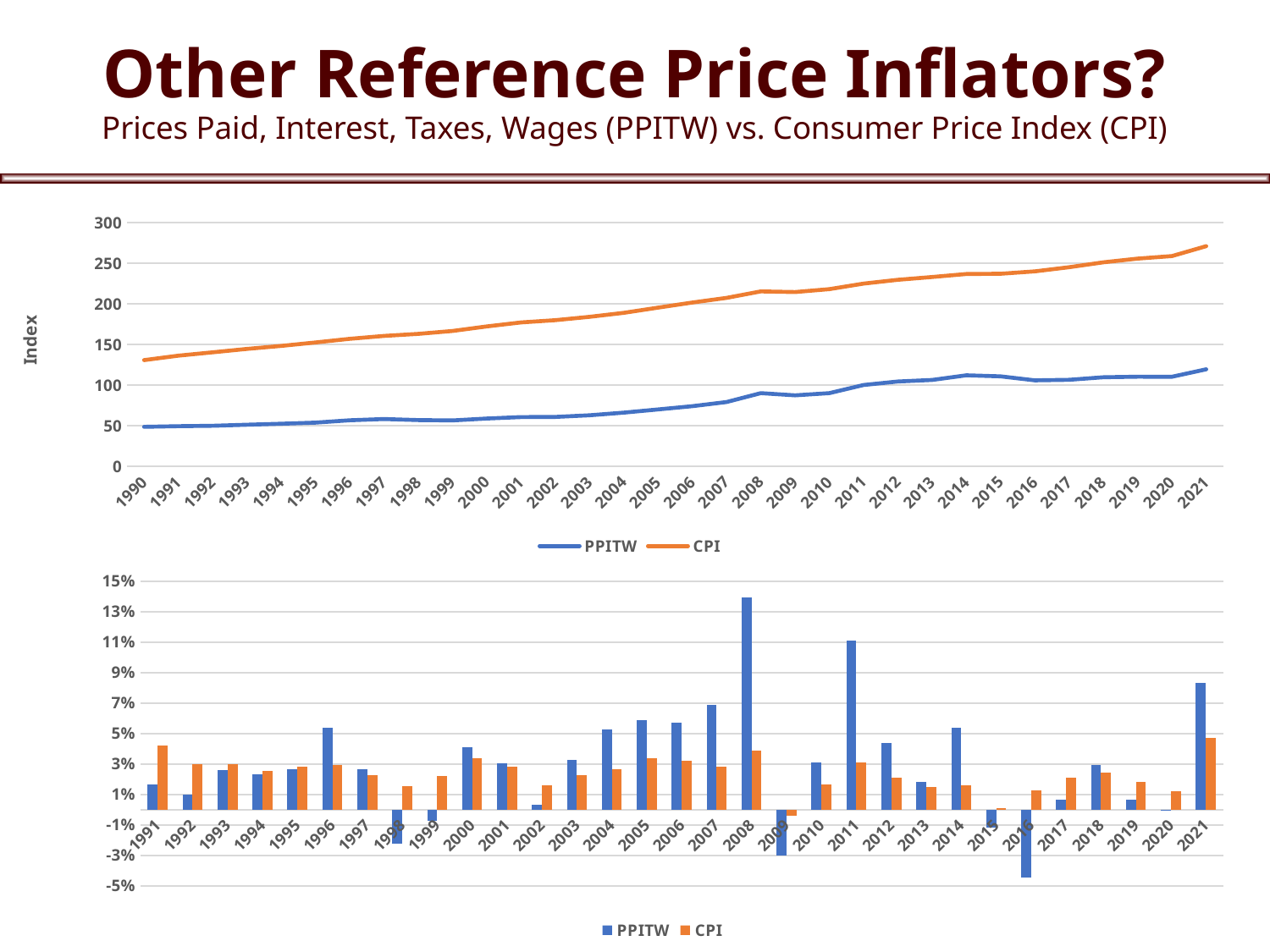
In the top line chart, how many series does the legend list? 2 What kind of chart is the top chart on the slide? line chart In the top line chart, is the CPI value for 2021 greater or less than 250? greater In the top line chart, do the CPI values rise or fall from 1990 to 2021? rise In the bottom bar chart, how many years are shown along the x axis? 31 In the top line chart, which series is higher in 2010, PPITW or CPI? CPI In the bottom bar chart, which year has the highest PPITW value? 2008 In the bottom bar chart, is the PPITW value for 2008 greater or less than 13%? greater In the top line chart, how many years are plotted along the x axis? 32 In the bottom bar chart, which year has the lowest PPITW value? 2016 What kind of chart is the bottom chart on the slide? bar chart